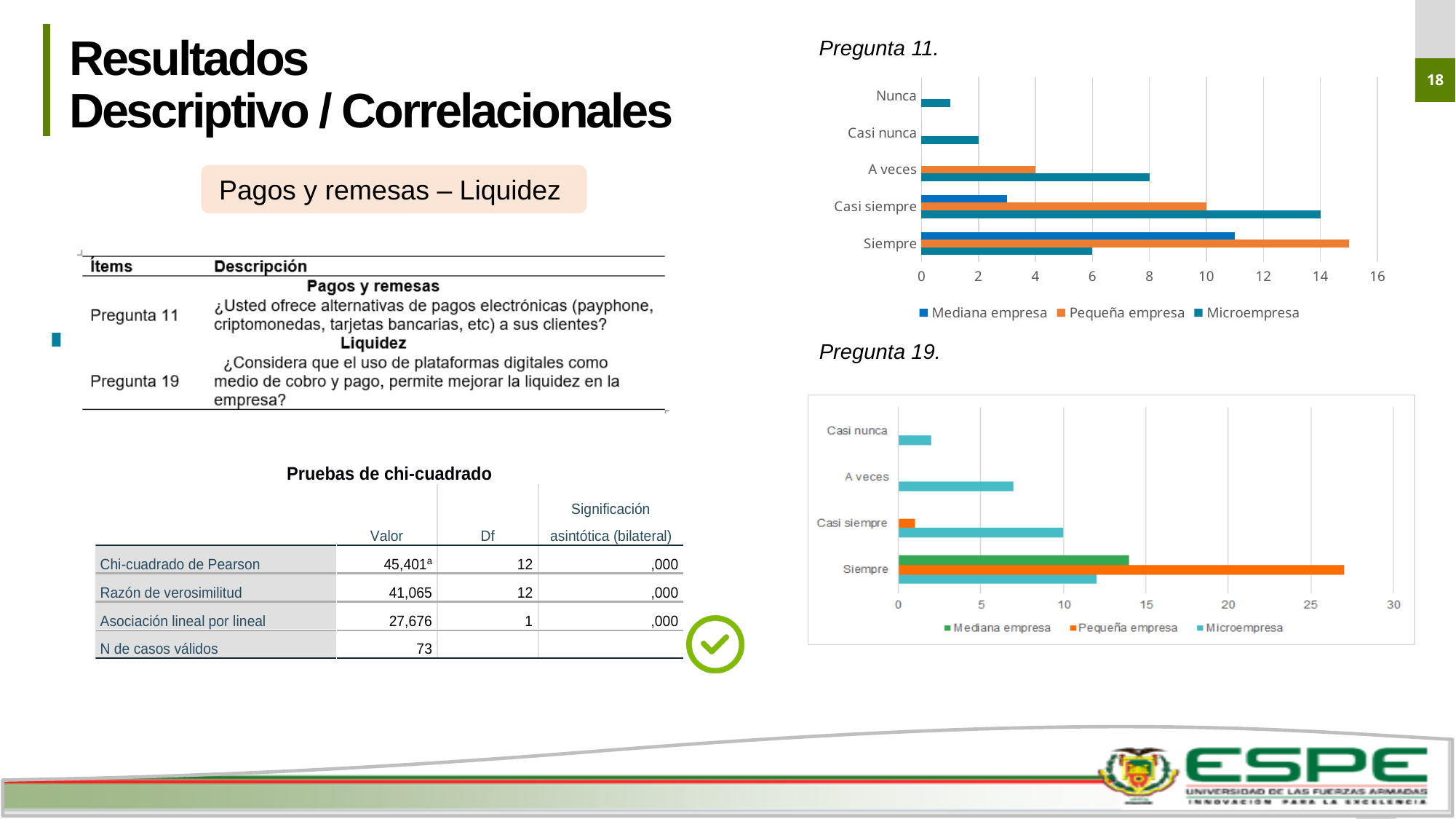
In the Pregunta 11 chart, how many response categories are listed on the vertical axis? 5 In the Pregunta 11 chart, for Siempre, which is larger: Mediana empresa or Microempresa? Mediana empresa In the Pregunta 19 chart, what colour represents Pequeña empresa in the legend? Orange In the Pregunta 11 chart, what kind of chart is shown? Bar chart In the Pregunta 19 chart, for Microempresa, which is larger: A veces or Casi siempre? Casi siempre In the Pregunta 11 chart, is the Microempresa value for Casi siempre greater or less than 12? greater In the Pregunta 19 chart, how many response categories are listed on the vertical axis? 4 In the Pregunta 11 chart, for which category is the Pequeña empresa bar the longest? Siempre In the Pregunta 11 chart, is the Pequeña empresa value for A veces greater or less than 6? less In the Pregunta 11 chart, how many series does the legend list? 3 In the Pregunta 19 chart, which series has the longest bar for Siempre? Pequeña empresa In the Pregunta 19 chart, is the Pequeña empresa value for Siempre greater or less than 25? greater